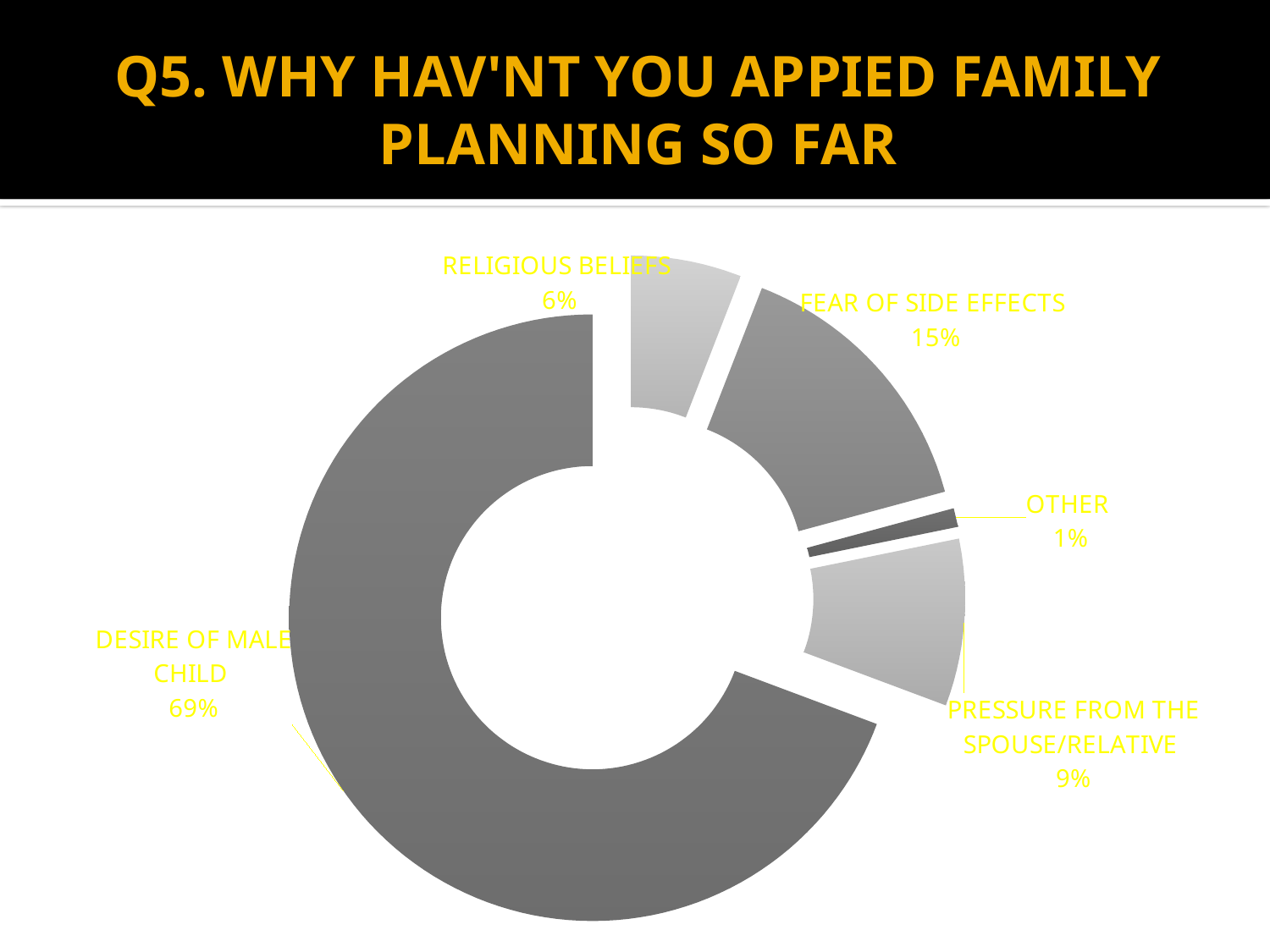
What percentage is shown for PRESSURE FROM THE SPOUSE/RELATIVE? 9% What is the title of the slide? Q5. WHY HAV'NT YOU APPIED FAMILY PLANNING SO FAR How many categories are shown in the chart? 5 What percentage is shown for RELIGIOUS BELIEFS? 6% What share of responses is labelled DESIRE OF MALE CHILD? 69% What percentage is shown for FEAR OF SIDE EFFECTS? 15% Which is larger, the share for RELIGIOUS BELIEFS or the share for PRESSURE FROM THE SPOUSE/RELATIVE? PRESSURE FROM THE SPOUSE/RELATIVE What is the difference in percentage points between DESIRE OF MALE CHILD and FEAR OF SIDE EFFECTS? 54 Which category has the largest share of the chart? DESIRE OF MALE CHILD Which category has the smallest share of the chart? OTHER What type of chart is shown on the slide? Doughnut (pie) chart What percentage is shown for OTHER? 1%